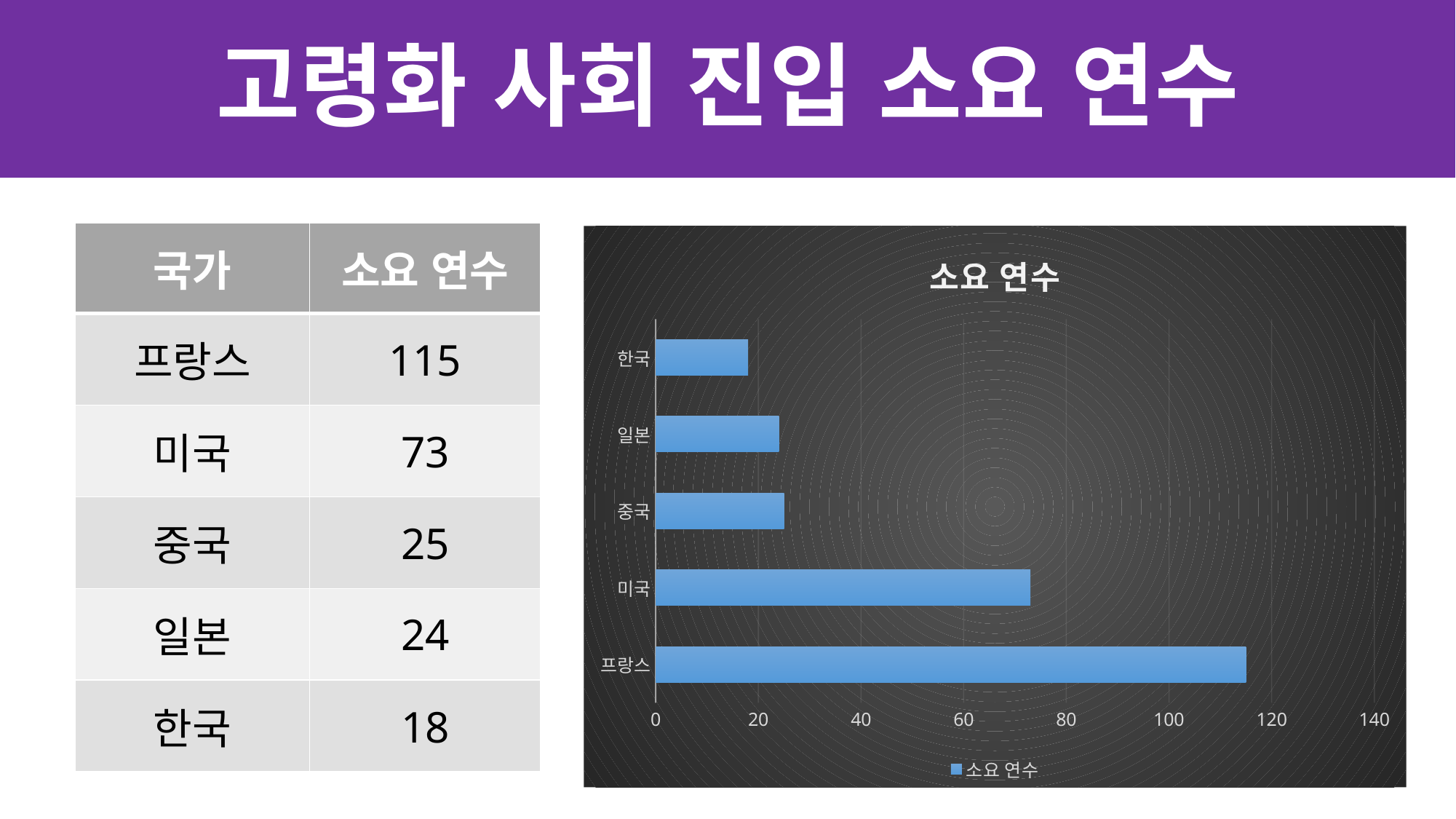
Which is larger, the value for 미국 or the value for 중국? 미국 What kind of chart is shown on the slide? bar chart What is the difference between the values for 프랑스 and 미국? 42 Is the value for 미국 greater or less than 60? greater What is the title of the chart? 소요 연수 What is the value for 한국? 18 Which country has the lowest value in the chart? 한국 How many countries are plotted in the chart? 5 How many series does the chart legend list? 1 What is the value for 미국? 73 What is the value for 프랑스? 115 Which country has the highest value in the chart? 프랑스